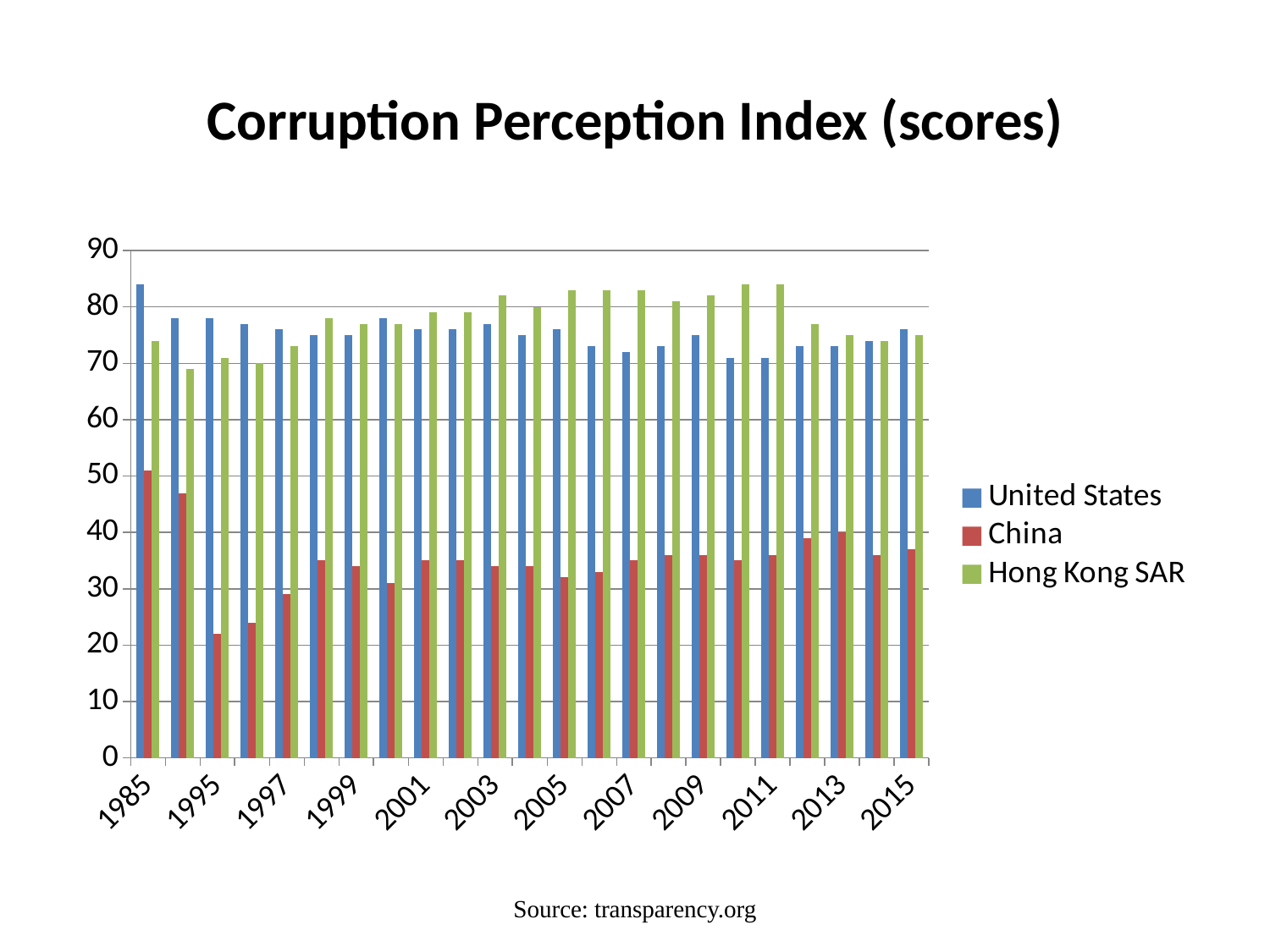
Is the value for the United States in 1985 greater or less than 80? greater Which series has the highest value in 2005? Hong Kong SAR What kind of chart is shown on the slide? Bar chart In 2011, which is larger: the value for Hong Kong SAR or for the United States? Hong Kong SAR Is the value for Hong Kong SAR in 2011 greater or less than 80? greater Is the value for China in 1995 greater or less than 30? less Which series has the lowest value in 2015? China How many series does the legend list? 3 In 1985, which is larger: the value for the United States or for Hong Kong SAR? United States What is the title of the chart? Corruption Perception Index (scores) Which colour represents China in the chart? Red